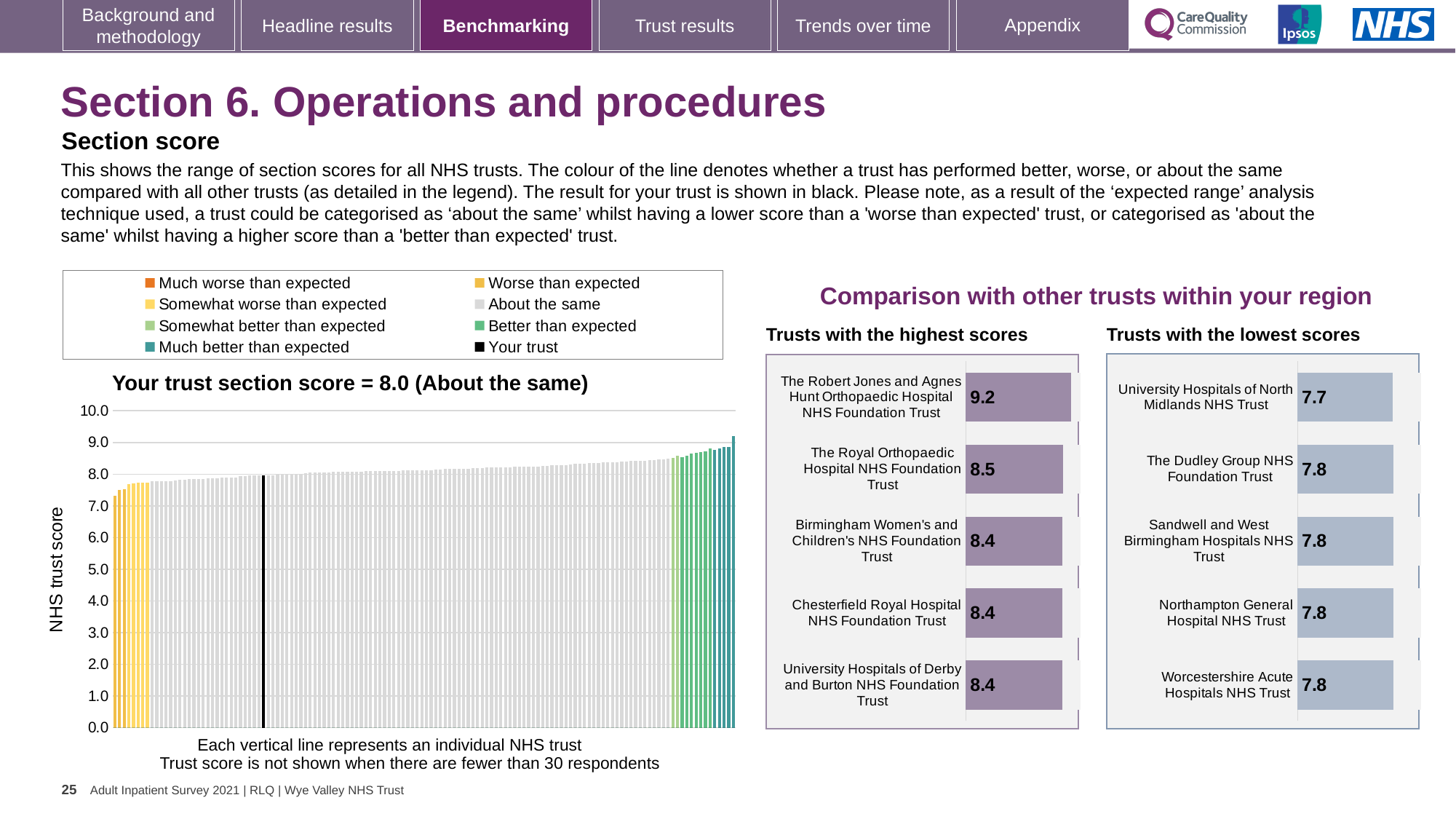
On the 'Trusts with the highest scores' chart, what is the difference between the scores of The Robert Jones and Agnes Hunt Orthopaedic Hospital NHS Foundation Trust and The Royal Orthopaedic Hospital NHS Foundation Trust? 0.7 On the 'Your trust section score' chart, what is the section score for your trust? 8.0 On the 'Your trust section score' chart, is the value of the lowest-scoring trust greater or less than 7.0? greater On the 'Trusts with the highest scores' chart, which trust has the highest score? The Robert Jones and Agnes Hunt Orthopaedic Hospital NHS Foundation Trust On the 'Your trust section score' chart, how many entries does the legend list? 8 On the 'Your trust section score' chart, which legend colour represents your trust? Black On the 'Trusts with the highest scores' chart, how many trusts are shown? 5 On the 'Trusts with the lowest scores' chart, what is the score for Worcestershire Acute Hospitals NHS Trust? 7.8 On the 'Trusts with the highest scores' chart, what is the score for The Robert Jones and Agnes Hunt Orthopaedic Hospital NHS Foundation Trust? 9.2 On the 'Your trust section score' chart, do the trust scores rise or fall from left to right along the x axis? Rise What kind of chart is the 'Your trust section score' chart? Bar chart On the 'Trusts with the lowest scores' chart, which trust has the lowest score? University Hospitals of North Midlands NHS Trust